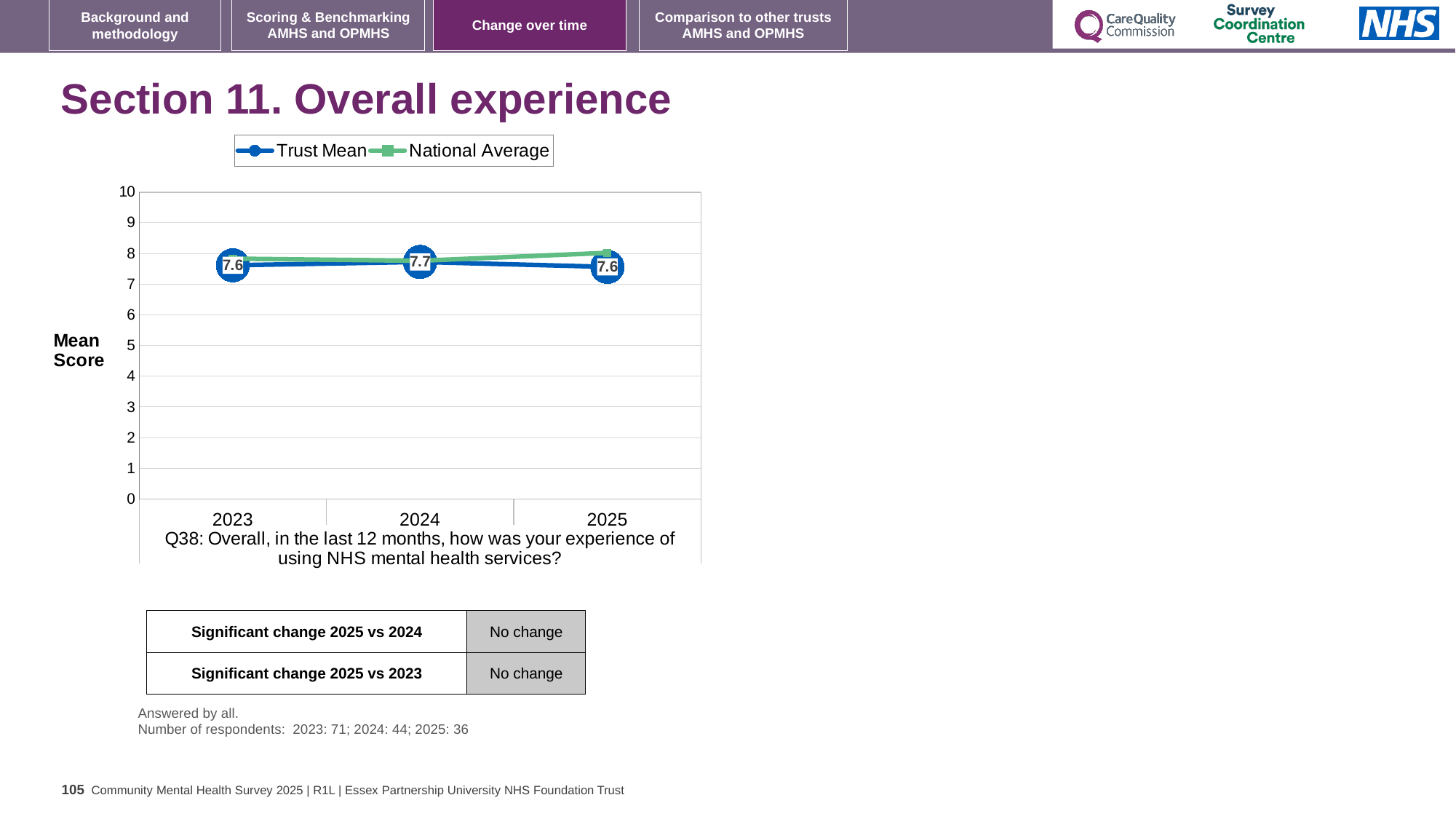
What is the label on the y axis of the chart? Mean Score Does the Trust Mean rise or fall from 2024 to 2025? Fall Is the Trust Mean larger in 2024 or in 2025? 2024 How many years are plotted on the x axis? 3 What is the Trust Mean for 2025? 7.6 Is the National Average for 2025 greater or less than 5? greater What is the Trust Mean for 2023? 7.6 What is the Trust Mean for 2024? 7.7 What is the difference between the Trust Mean in 2024 and in 2023? 0.1 What kind of chart is shown on the slide? Line chart In which year is the Trust Mean highest? 2024 How many series does the legend list? 2